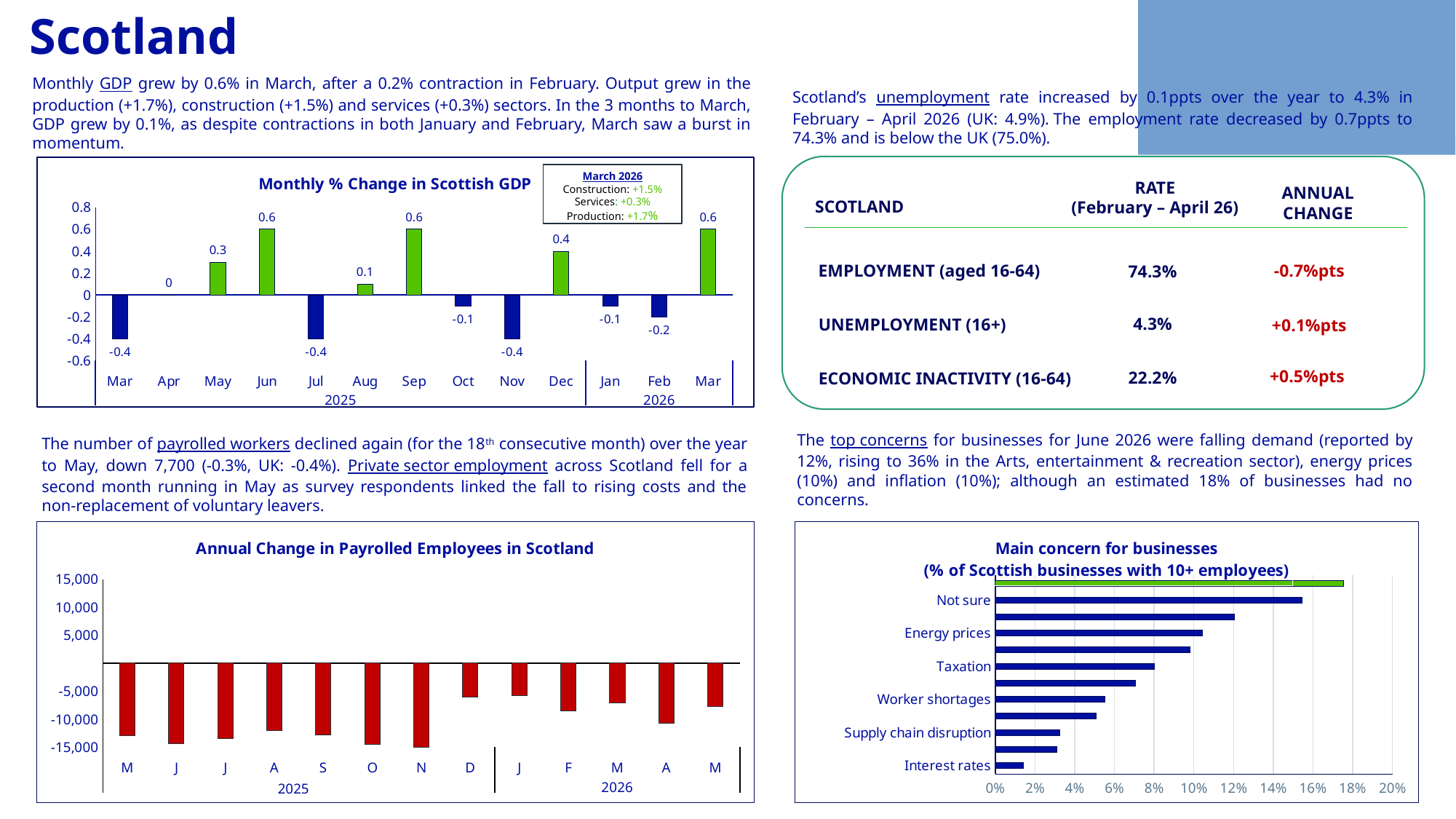
In the 'Monthly % Change in Scottish GDP' chart, which is larger, the value for May 2025 or the value for Aug 2025? May 2025 In the 'Monthly % Change in Scottish GDP' chart, how many months are plotted? 13 In the 'Monthly % Change in Scottish GDP' chart, what is the difference between the Dec 2025 value and the Nov 2025 value? 0.8 What kind of chart is 'Annual Change in Payrolled Employees in Scotland'? bar chart In the 'Main concern for businesses' chart, which is larger, the value for Energy prices or the value for Taxation? Energy prices In the 'Monthly % Change in Scottish GDP' chart, what is the value for Dec 2025? 0.4 In the 'Monthly % Change in Scottish GDP' chart, what is the value for Feb 2026? -0.2 In the 'Main concern for businesses' chart, which labelled concern has the lowest value? Interest rates In the 'Monthly % Change in Scottish GDP' chart, what is the value for Jun 2025? 0.6 In the 'Annual Change in Payrolled Employees in Scotland' chart, is the value for N 2025 greater or less than -10,000? less In the 'Annual Change in Payrolled Employees in Scotland' chart, is the value for D 2025 greater or less than -10,000? greater In the 'Main concern for businesses' chart, is the value for Interest rates greater or less than 2%? less